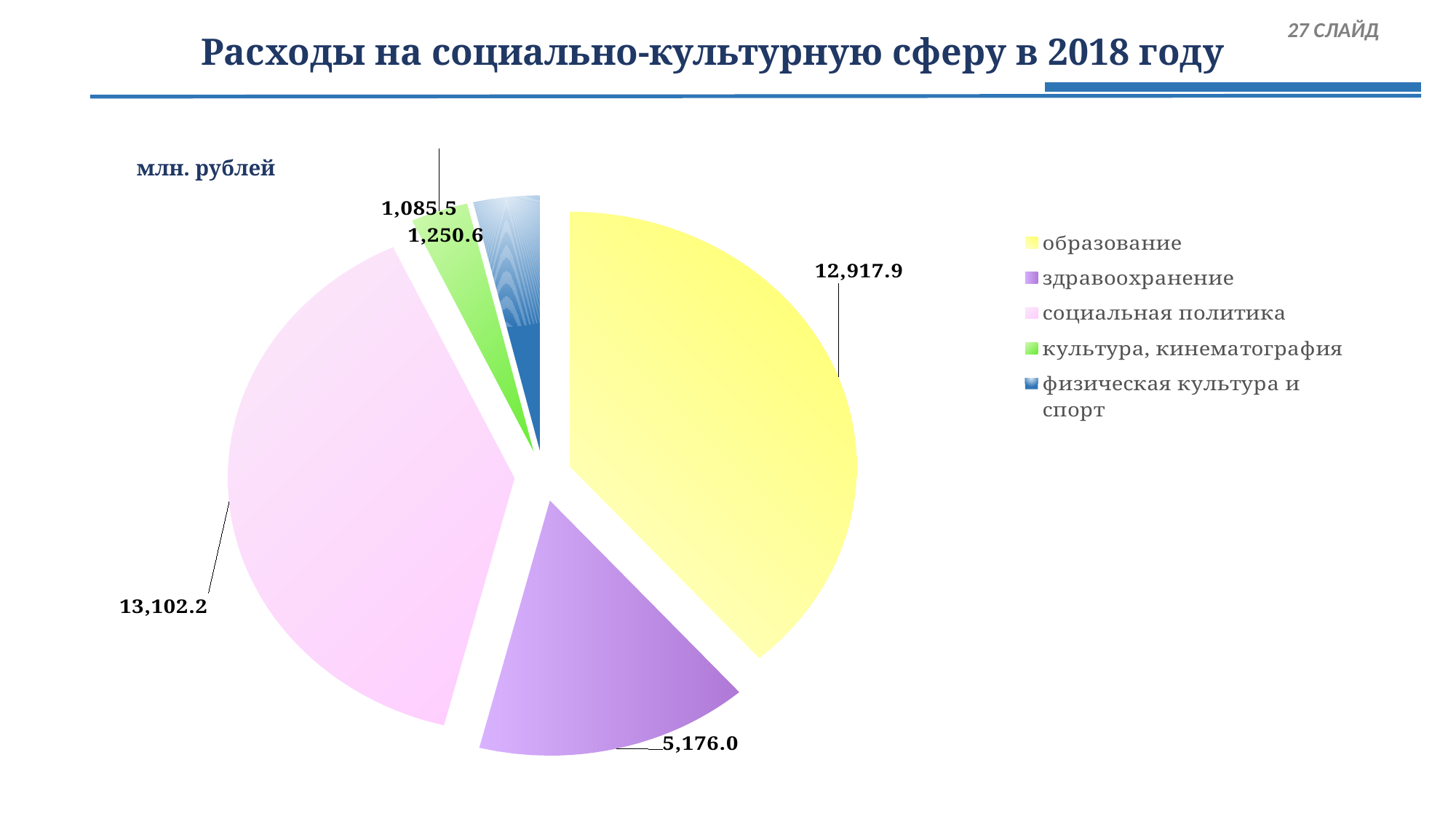
Which category has the largest value? социальная политика What is the value for здравоохранение? 5,176.0 What is the value for культура, кинематография? 1,085.5 What is the value for физическая культура и спорт? 1,250.6 Which category has the smallest value? культура, кинематография What is the value for социальная политика? 13,102.2 How many categories does the pie chart have? 5 Which is larger, the value for культура, кинематография or физическая культура и спорт? физическая культура и спорт What is the value for образование? 12,917.9 What type of chart is shown on the slide? pie chart What is the difference between the values for социальная политика and образование? 184.3 What unit is indicated for the chart values? млн. рублей